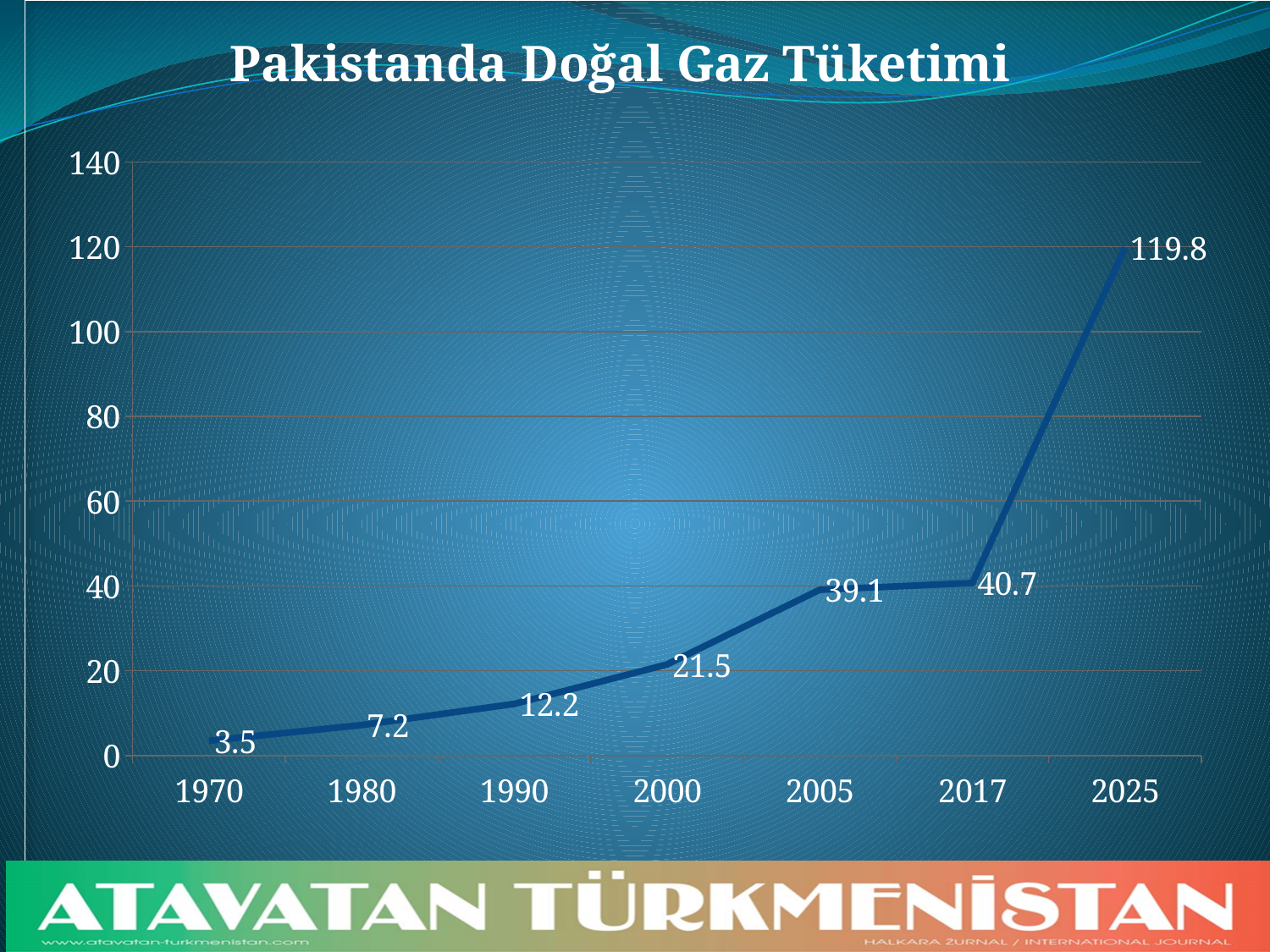
Which year has the lowest value? 1970 What is the value for 1970? 3.5 Do the values rise or fall from 1970 to 2025? rise How many years are plotted on the chart? 7 Which is larger, the value for 2005 or the value for 2000? 2005 What kind of chart is shown? line chart Is the value for 2017 greater or less than 60? less What is the difference between the values for 2025 and 2017? 79.1 What is the value for 2025? 119.8 What is the value for 2000? 21.5 Which year has the highest value? 2025 What is the difference between the values for 1990 and 1980? 5